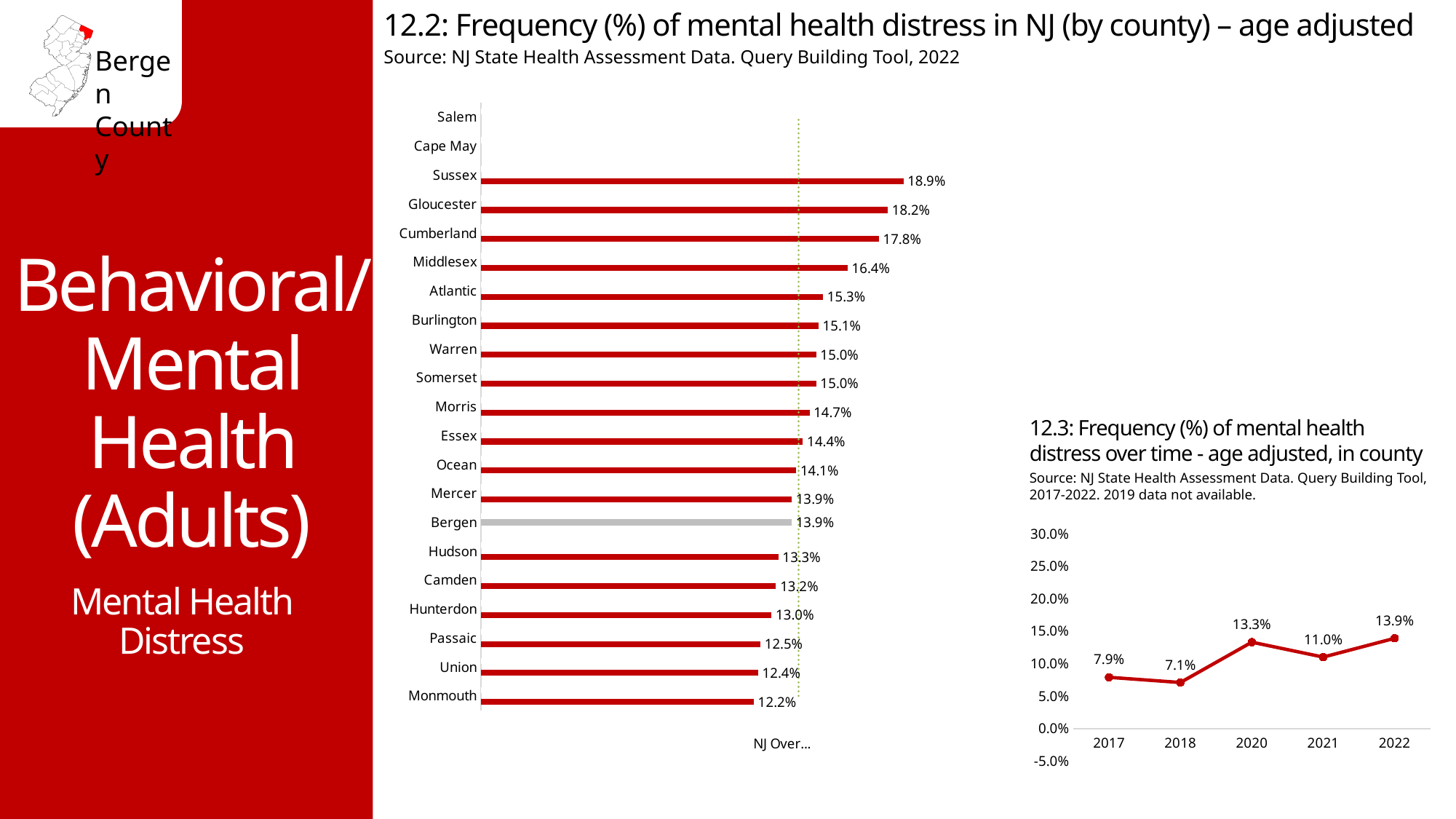
In chart 12.2, what is the frequency of mental health distress for Sussex? 18.9% In chart 12.2, which county with a plotted bar has the lowest frequency of mental health distress? Monmouth In chart 12.2, which county has a higher value, Middlesex or Essex? Middlesex How many years are plotted in chart 12.3? 5 In chart 12.2, which county has the highest frequency of mental health distress? Sussex In chart 12.3, what is the difference between the 2022 and 2017 values? 6.0% In chart 12.2, what is the difference between the values for Gloucester and Hudson? 4.9% What type of chart is chart 12.2? Bar chart In chart 12.3, what is the frequency of mental health distress in 2018? 7.1% In chart 12.2, what is the value shown for Bergen? 13.9% What type of chart is chart 12.3? Line chart In chart 12.3, which year has the highest value? 2022